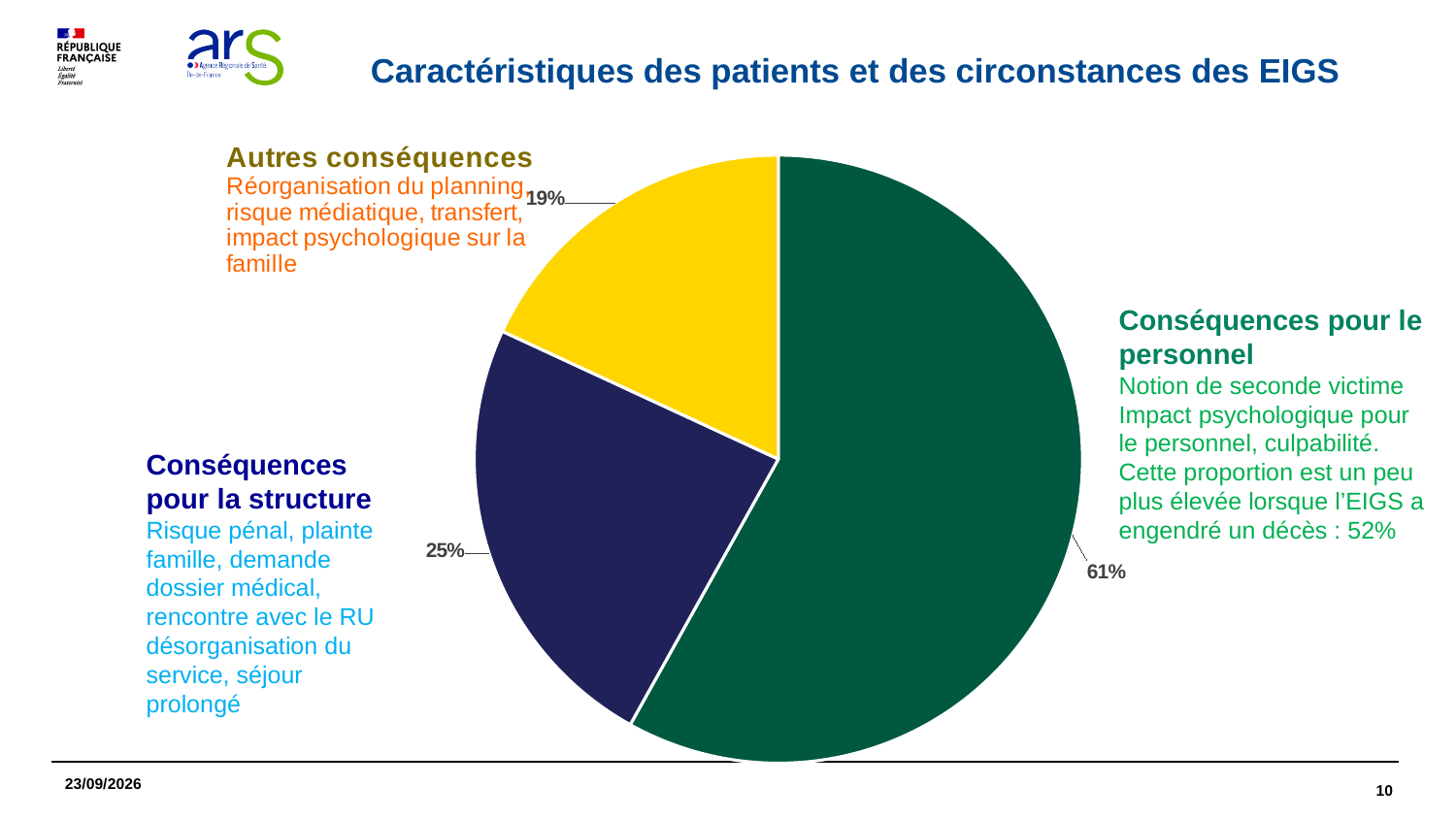
What percentage is shown for the green slice (Conséquences pour le personnel)? 61% What colour is the slice labelled 61%? green What percentage is shown for the dark blue slice (Conséquences pour la structure)? 25% What percentage is shown for the yellow slice (Autres conséquences)? 19% Which slice of the pie chart is the largest? Conséquences pour le personnel (61%) Which is larger: the Conséquences pour la structure slice or the Autres conséquences slice? Conséquences pour la structure What kind of chart is shown on the slide? pie chart What is the difference in percentage points between the Conséquences pour la structure slice and the Autres conséquences slice? 6 percentage points What is the difference in percentage points between the Conséquences pour le personnel slice and the Conséquences pour la structure slice? 36 percentage points How many slices does the pie chart have? 3 Which slice of the pie chart is the smallest? Autres conséquences (19%) According to the text next to the chart, what is the proportion of Conséquences pour le personnel when the EIGS caused a death? 52%